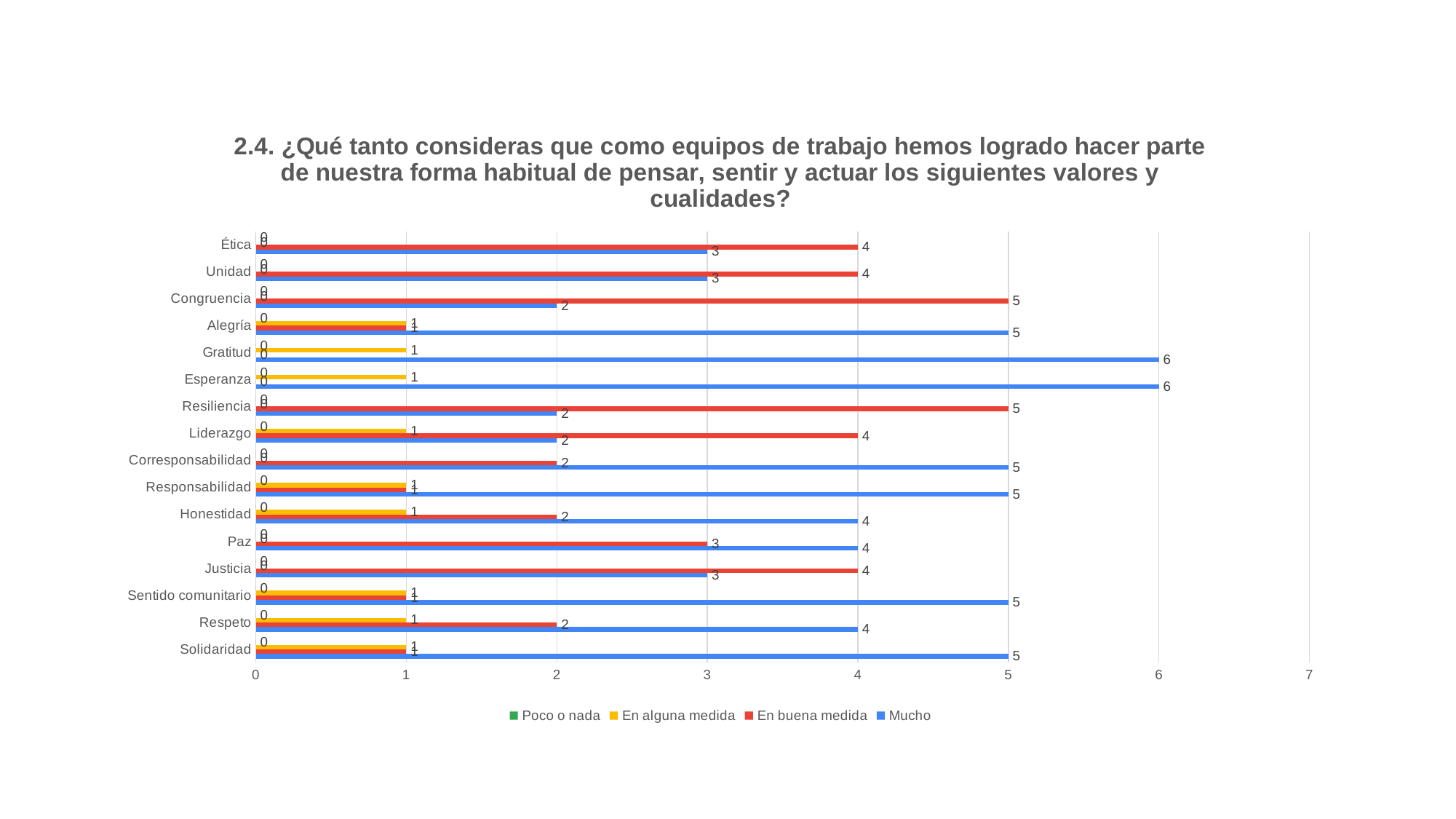
What is the total of all four series values for Honestidad? 7 What is the value of the "Mucho" series for Liderazgo? 2 For Ética, what is the difference between the "En buena medida" value and the "Mucho" value? 1 Which has the larger "Mucho" value: Esperanza or Honestidad? Esperanza What is the value of the "En alguna medida" series for Respeto? 1 What colour represents the "Mucho" series in the legend? Blue What is the value of the "Mucho" series for Gratitud? 6 How many series does the legend list? 4 What kind of chart is shown on the slide? Bar chart How many categories (values/qualities) are listed on the y axis? 16 For Paz, which series has the larger value: "En buena medida" or "Mucho"? Mucho What is the value of the "En buena medida" series for Congruencia? 5